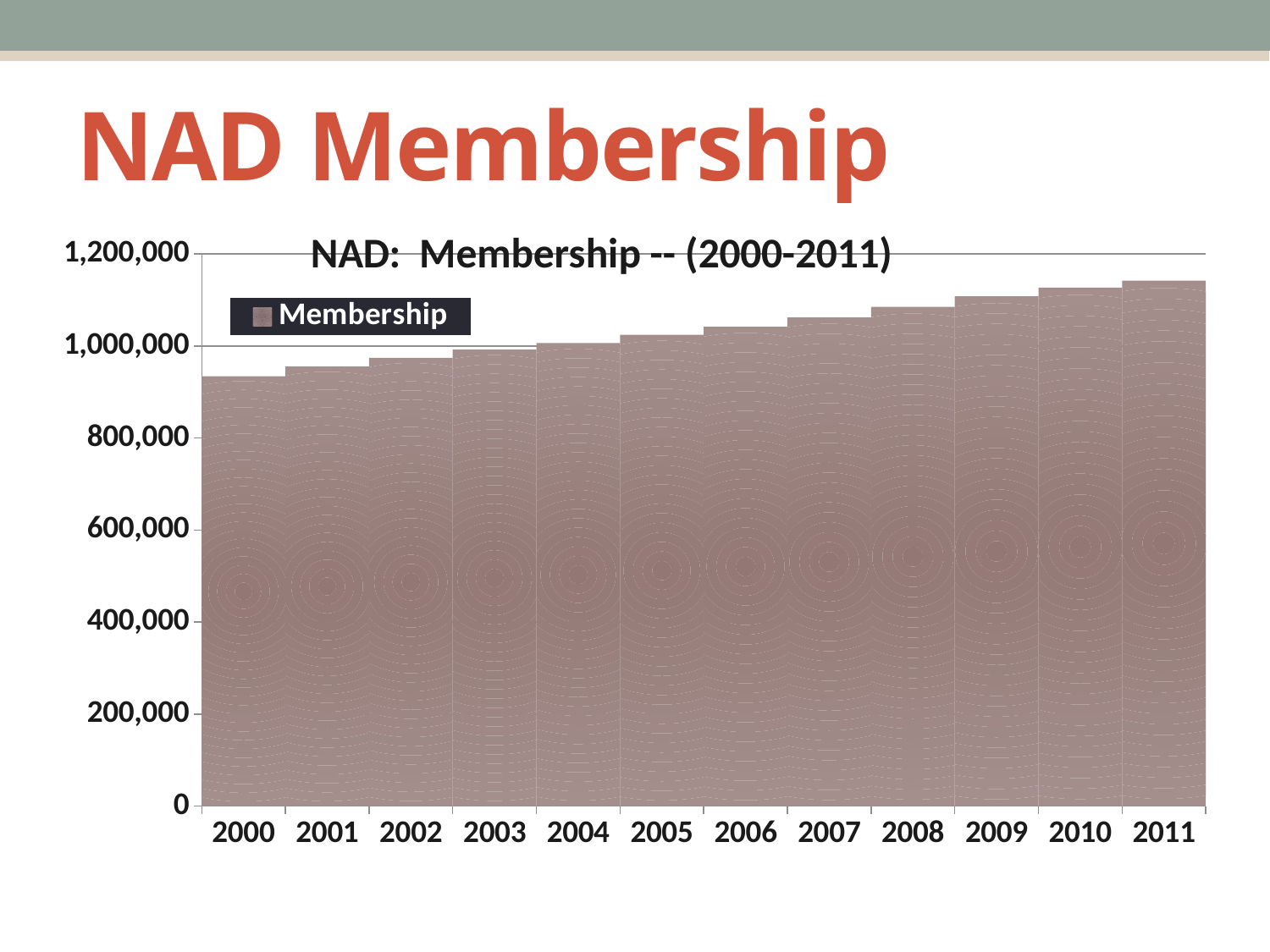
Which year has the lowest membership? 2000 What is the title of the chart? NAD: Membership -- (2000-2011) Which year has the highest membership? 2011 Is the membership value for 2000 greater or less than 1,000,000? less Is the membership value for 2011 greater or less than 1,200,000? less Do membership values rise or fall from 2000 to 2011? rise How many years are plotted on the x axis? 12 Which year has the larger membership, 2002 or 2009? 2009 Is the membership value for 2011 greater or less than 1,000,000? greater How many series does the legend list? 1 What kind of chart is shown on the slide? bar chart What is the name of the series shown in the legend? Membership